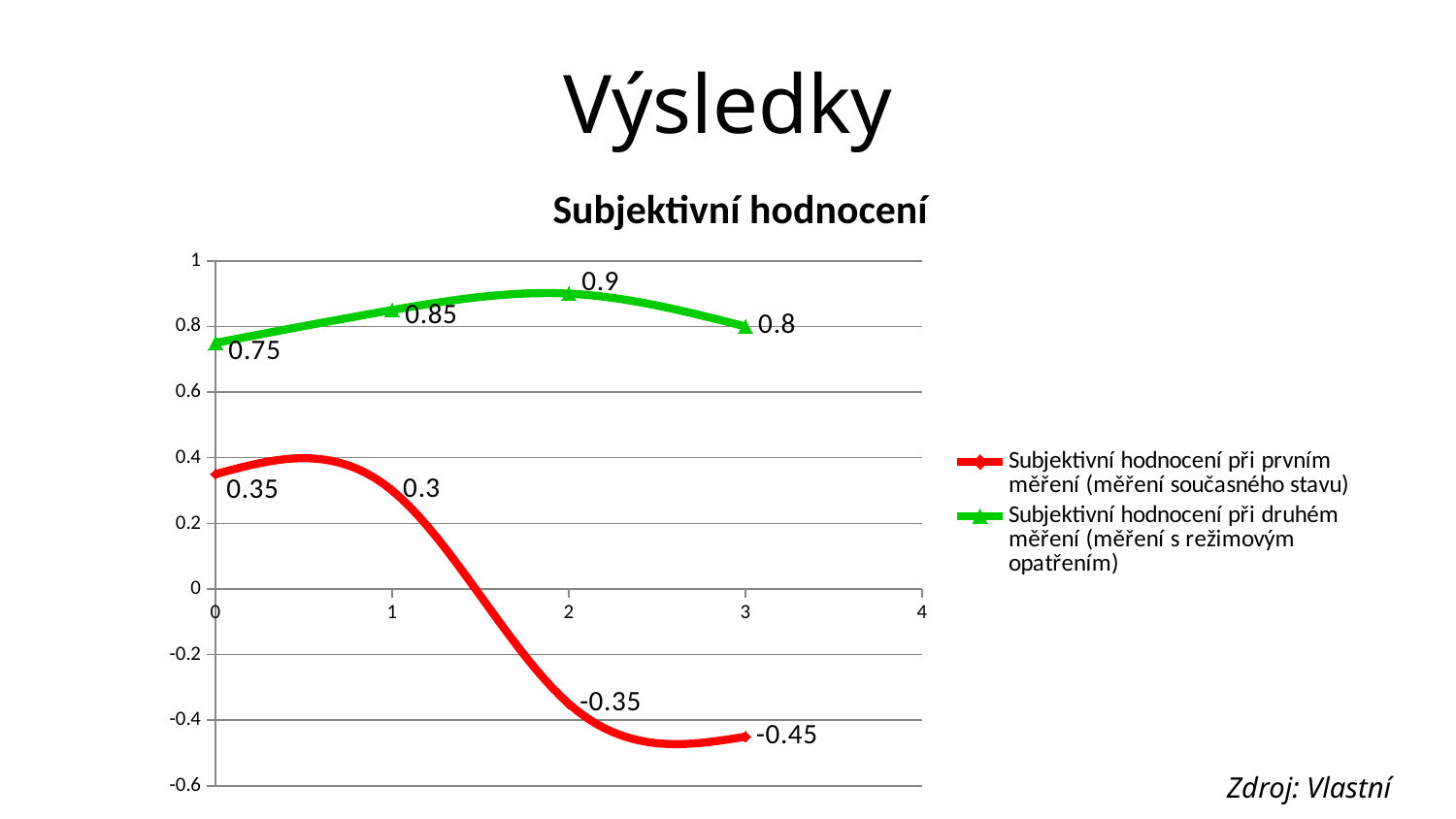
How many series does the legend list? 2 What type of chart is shown on the slide? line chart How many data points does the green series (druhé měření) have? 4 What is the value of the second-measurement series (druhé měření) at x = 2? 0.9 At which x value does the second-measurement series (druhé měření) reach its highest value? 2 What is the difference between the second-measurement and first-measurement values at x = 3? 1.25 What is the value of the first-measurement series (první měření) at x = 3? -0.45 Which series has the larger value at x = 1, první měření or druhé měření? druhé měření What is the title of the chart? Subjektivní hodnocení What is the value of the first-measurement series (první měření) at x = 0? 0.35 Does the first-measurement series (první měření) rise or fall from x = 1 to x = 3? fall At which x value does the first-measurement series (první měření) reach its lowest value? 3